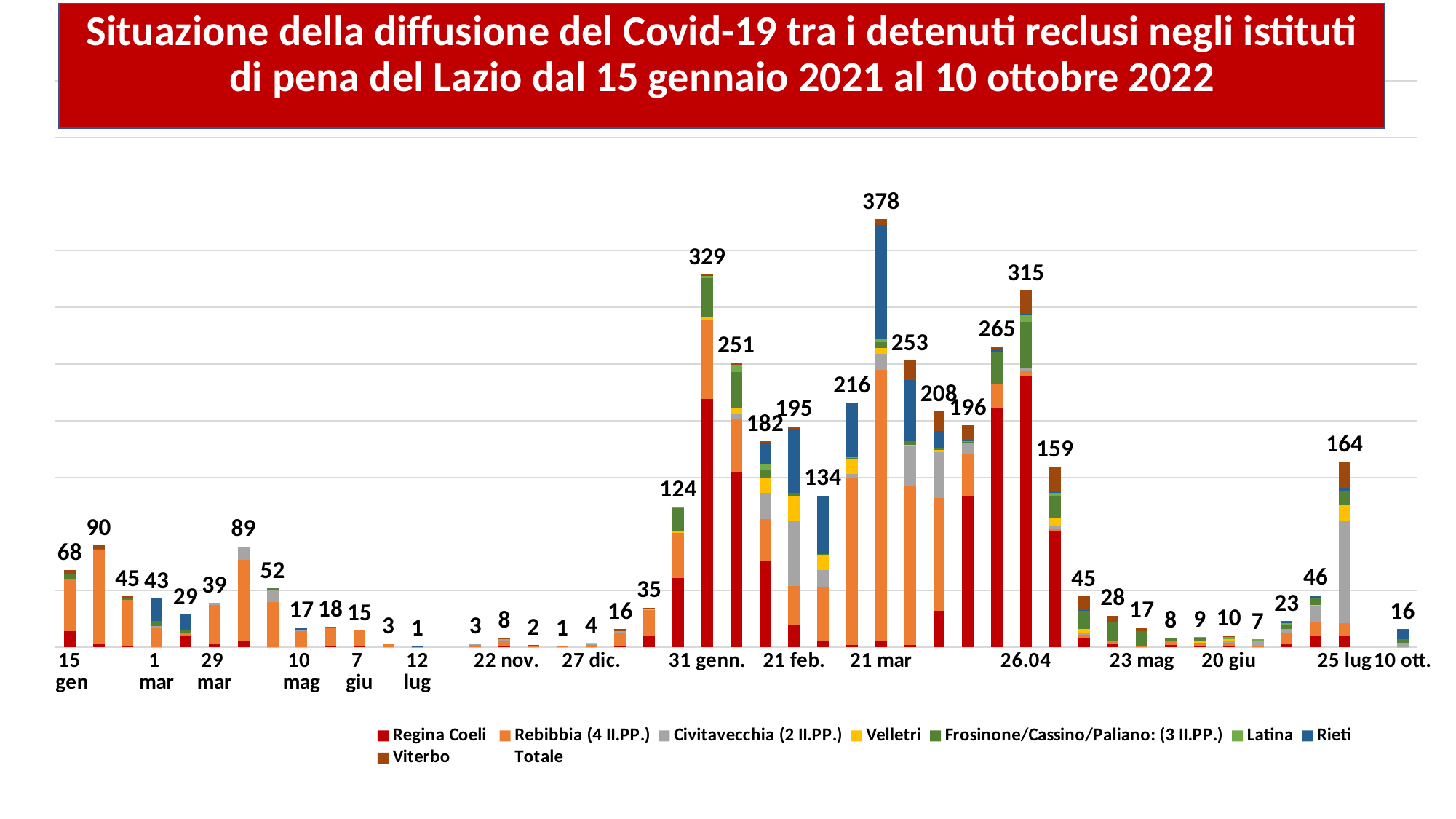
What kind of chart is shown on the slide? Stacked bar chart What is the total value labelled for 26.04? 315 Which date has the highest total on the chart? 21 mar What is the total value labelled for 25 lug? 164 What is the total value labelled for 10 ott.? 16 What is the highest total value labelled on the chart? 378 What is the difference between the totals for 21 mar and 31 genn.? 49 What colour represents Regina Coeli in the legend? Red How many entries does the legend list? 9 Which has a larger total, 31 genn. or 26.04? 31 genn. What is the total value labelled for 15 gen? 68 What is the total value labelled for 31 genn.? 329